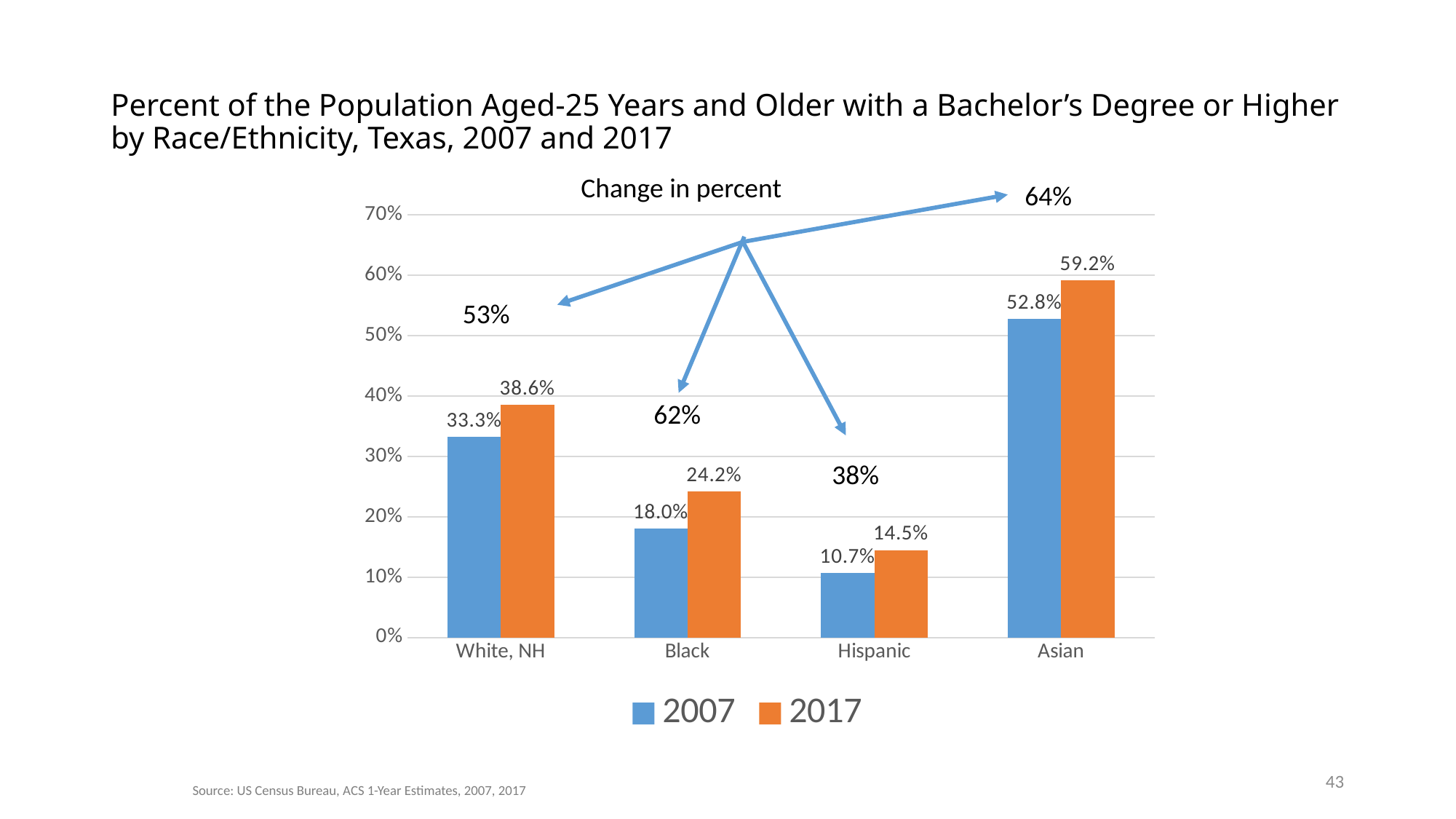
What was the percent of the population aged 25 and older with a bachelor's degree or higher for Hispanic in 2017? 14.5% Which race/ethnicity group had the lowest value in 2007? Hispanic What kind of chart is shown on the slide? Bar chart How many race/ethnicity categories are shown on the x axis? 4 What change in percent is annotated for the Black group? 62% Which is larger: the 2017 value for Black or the 2007 value for White, NH? 2007 value for White, NH What was the value for Black in 2007? 18.0% What is the difference between the 2017 and 2007 values for White, NH? 5.3% Is the 2007 value for Asian greater or less than 50%? greater How many series does the legend list? 2 Which race/ethnicity group had the highest value in 2017? Asian What was the value for Asian in 2017? 59.2%